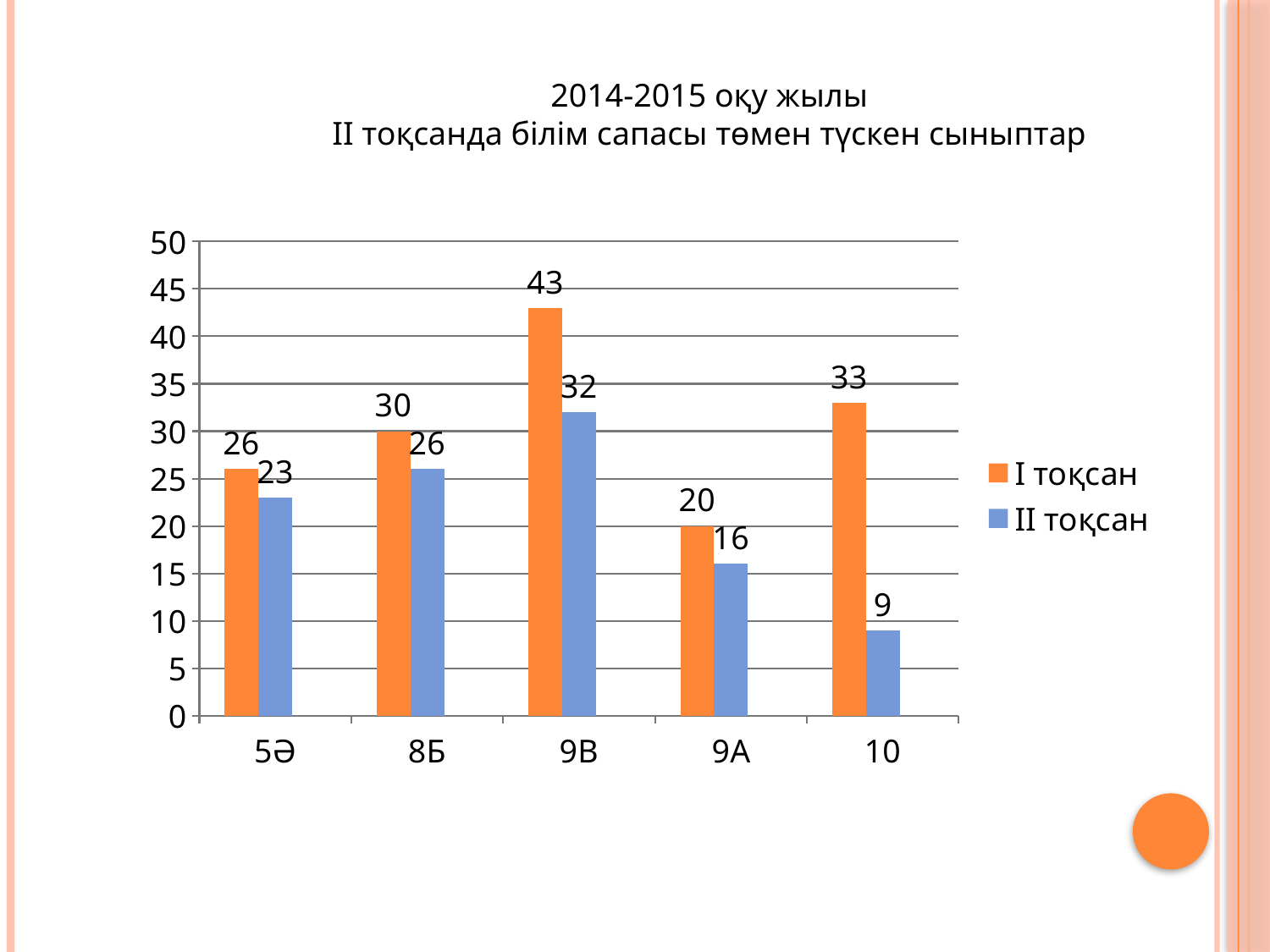
What is the value for 10 in the II тоқсан series? 9 What is the difference between the I тоқсан and II тоқсан values for 9В? 11 What colour are the bars for the II тоқсан series? blue Which category has the lowest value in the II тоқсан series? 10 Which is larger: the I тоқсан value for 5Ә or the I тоқсан value for 9А? 5Ә How many series does the legend list? 2 How many categories are shown on the x axis? 5 What is the difference between the I тоқсан and II тоқсан values for 10? 24 Which category has the highest value in the I тоқсан series? 9В What is the value for 8Б in the II тоқсан series? 26 What is the value for 9В in the I тоқсан series? 43 What kind of chart is shown on the slide? bar chart